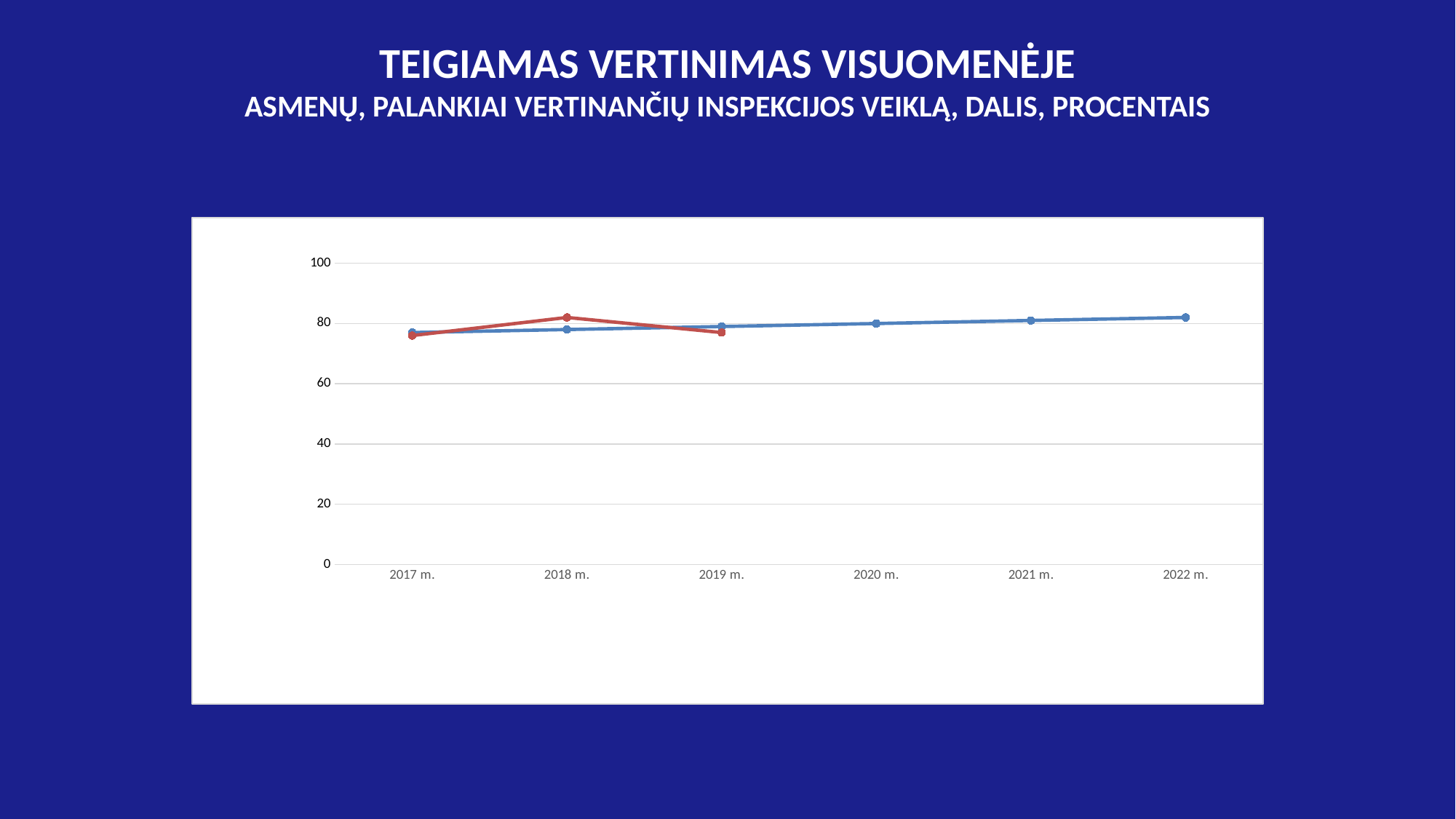
How many lines are plotted on the chart? 2 How many years are shown on the x axis of the chart? 6 Is the value of the red line for 2017 m. greater or less than 80? less Is the value of the blue line for 2017 m. greater or less than 80? less Is the value of the red line for 2018 m. greater or less than 60? greater Does the blue line rise or fall from 2017 m. to 2022 m.? rise What is the first year shown on the x axis? 2017 m. What is the last year shown on the x axis? 2022 m. What kind of chart is shown on the slide? line chart What is the highest value shown on the y axis of the chart? 100